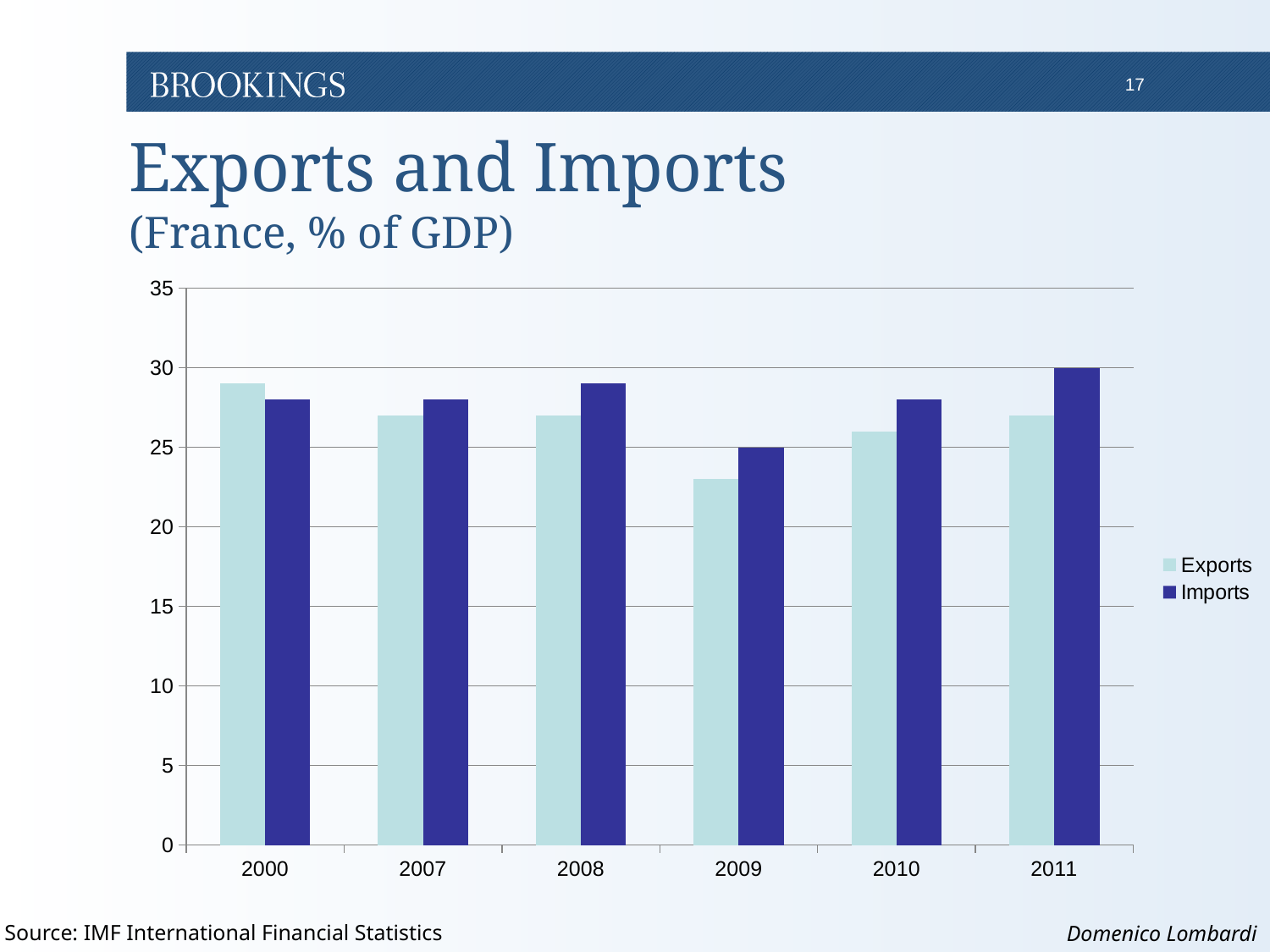
In 2011, which is larger, Exports or Imports? Imports Which year has the highest value for Exports? 2000 Which year has the lowest value for Imports? 2009 In 2009, which is larger, Exports or Imports? Imports How many years are shown on the x axis? 6 Which year has the lowest value for Exports? 2009 Is the value for Exports in 2009 greater or less than 25? less What kind of chart is shown on the slide? bar chart Is the value for Exports in 2011 greater or less than 30? less Is the value for Exports in 2000 greater or less than 25? greater How many series does the legend list? 2 What is the source cited for the chart data? IMF International Financial Statistics